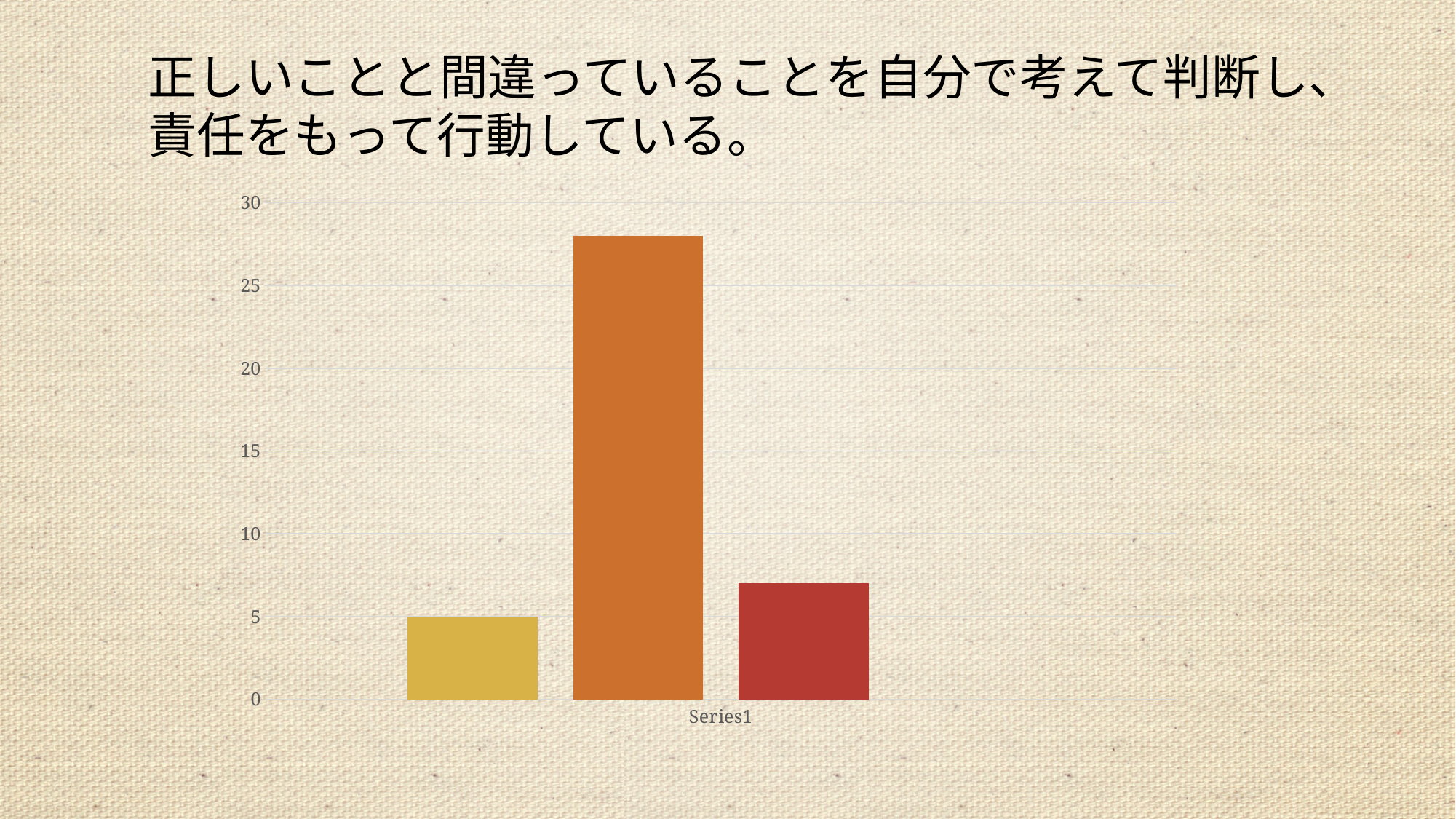
Which bar is the shortest in the chart: the yellow (left), orange (middle), or red (right) bar? yellow (left) How many bars are plotted in the chart? 3 What is the label shown on the horizontal axis of the chart? Series1 Which is larger, the value of the orange (middle) bar or the red (right) bar? orange (middle) bar Is the value of the red (right) bar greater or less than 10? less What is the highest value shown on the vertical axis of the chart? 30 Is the value of the orange (middle) bar greater or less than 25? greater What kind of chart is shown on the slide? bar chart Is the value of the orange (middle) bar greater or less than 30? less Which bar is the tallest in the chart: the yellow (left), orange (middle), or red (right) bar? orange (middle) Which is larger, the value of the red (right) bar or the yellow (left) bar? red (right) bar